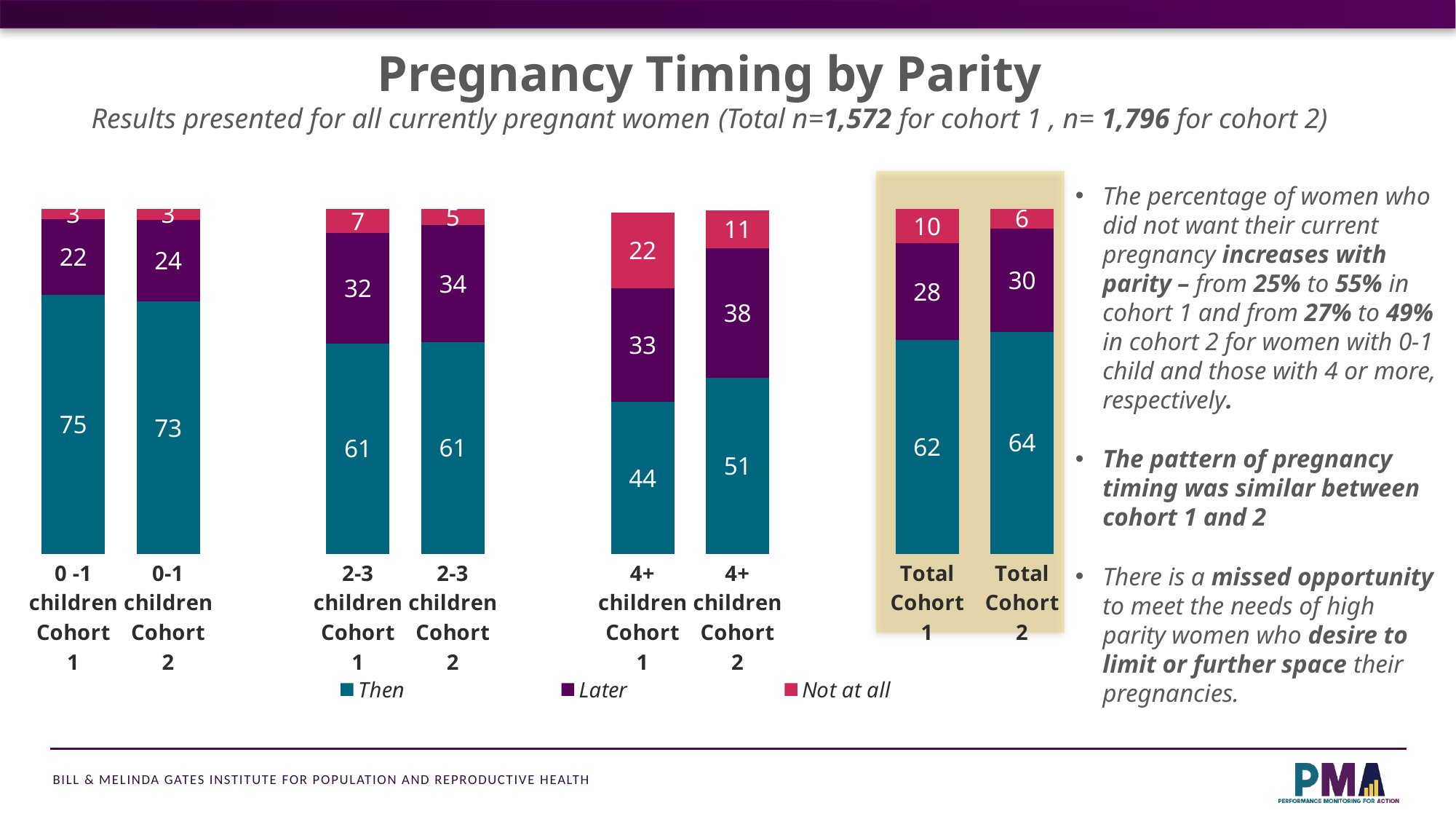
What is the difference between the 'Later' values for 4+ children Cohort 2 and 4+ children Cohort 1? 5 Which series is shown in teal in the legend? Then How many bars are shown in the chart? 10 What is the 'Not at all' value for 4+ children Cohort 1? 22 What is the total of the stacked bar for 2-3 children Cohort 1? 100 What is the 'Then' value for 0-1 children Cohort 1? 75 Which bar has the highest 'Then' value? 0-1 children Cohort 1 Which bar has the lowest 'Then' value? 4+ children Cohort 1 How many series does the legend list? 3 What is the 'Later' value for Total Cohort 2? 30 What kind of chart is shown on the slide? Stacked bar chart Which is larger, the 'Not at all' value for Total Cohort 1 or for Total Cohort 2? Total Cohort 1